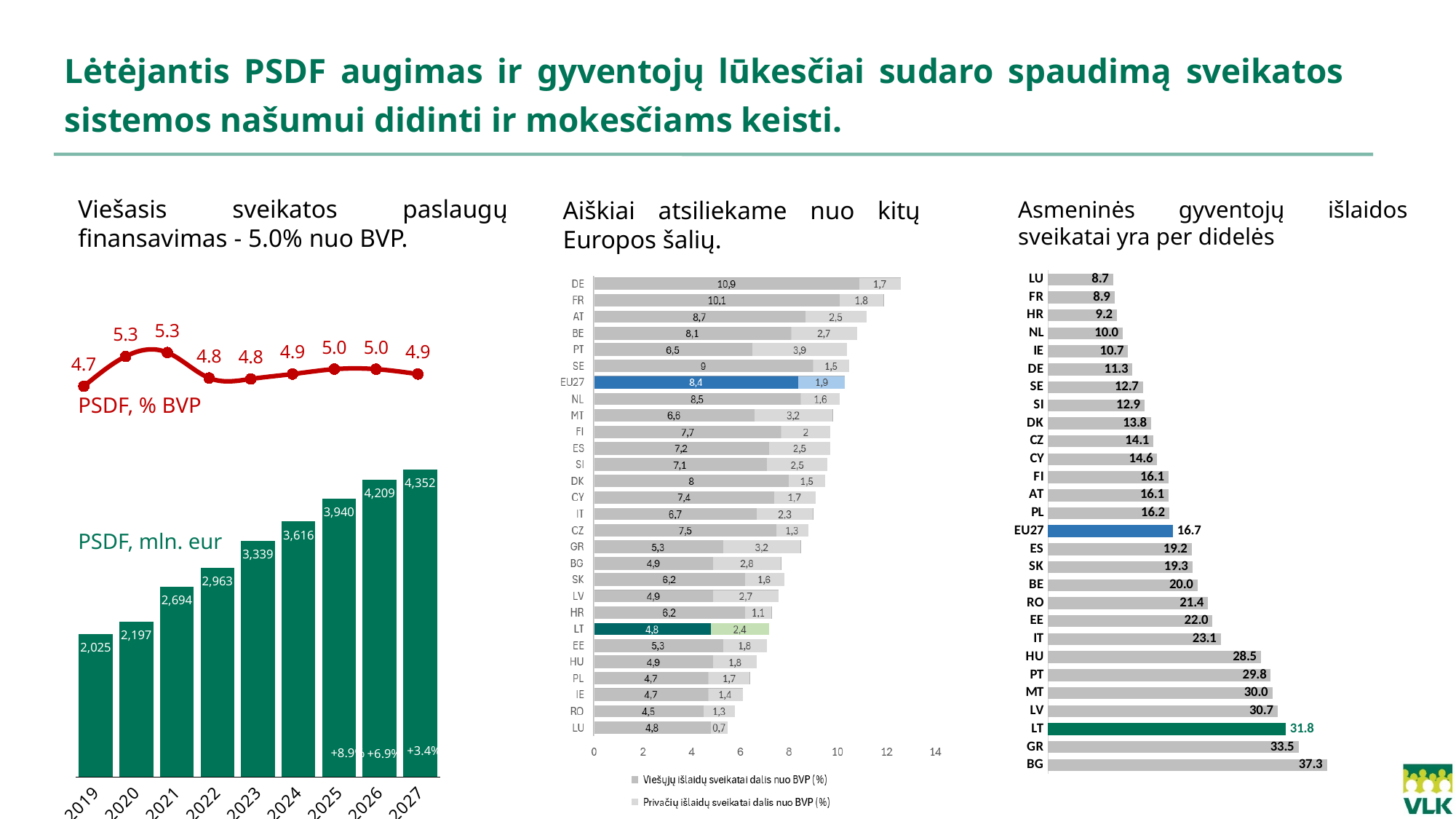
In the PSDF, mln. eur bar chart, do the values rise or fall from 2019 to 2027? rise In the right-hand bar chart of personal health expenditure, which country has the highest value? BG In the right-hand bar chart of personal health expenditure, what is the difference between LT and EU27? 15.1 In the middle stacked bar chart of health spending as % of GDP, what is the public spending value for LT? 4,8 In the middle stacked bar chart of health spending as % of GDP, what is the total of the LT bar? 7,2 How many years are shown in the PSDF, mln. eur bar chart? 9 How many series does the legend of the middle stacked bar chart list? 2 In the PSDF, mln. eur bar chart, what is the value for 2027? 4,352 In the PSDF, % BVP line chart, what is the value for 2019? 4.7 In the PSDF, mln. eur bar chart, which year has the lowest value? 2019 What kind of chart is the PSDF, mln. eur chart? bar chart In the PSDF, mln. eur bar chart, what is the difference between the 2027 and 2026 values? 143